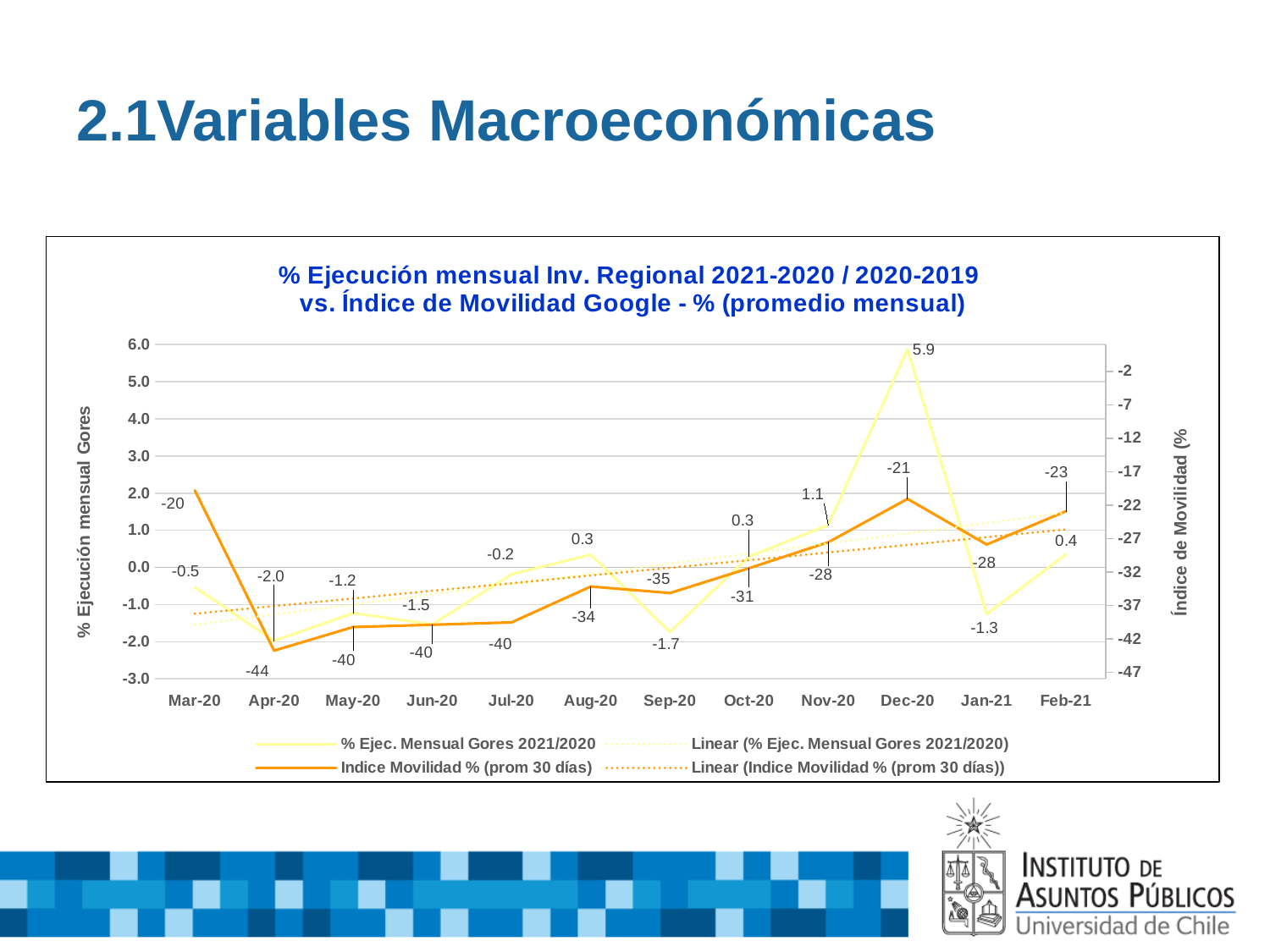
In which month is % Ejec. Mensual Gores 2021/2020 highest? Dec-20 What is the value of Indice Movilidad % (prom 30 días) for Feb-21? -23 What is the difference between the Indice Movilidad % values for Mar-20 and Apr-20? 24 How many entries does the legend list? 4 What kind of chart is shown on the slide? Line chart In which month is Indice Movilidad % (prom 30 días) lowest? Apr-20 What is the value of % Ejec. Mensual Gores 2021/2020 for Dec-20? 5.9 What is the label of the left vertical axis? % Ejecución mensual Gores What is the value of Indice Movilidad % (prom 30 días) for Apr-20? -44 Which is larger for % Ejec. Mensual Gores 2021/2020: Nov-20 or Jan-21? Nov-20 How many months are shown on the x axis? 12 What is the value of % Ejec. Mensual Gores 2021/2020 for Sep-20? -1.7